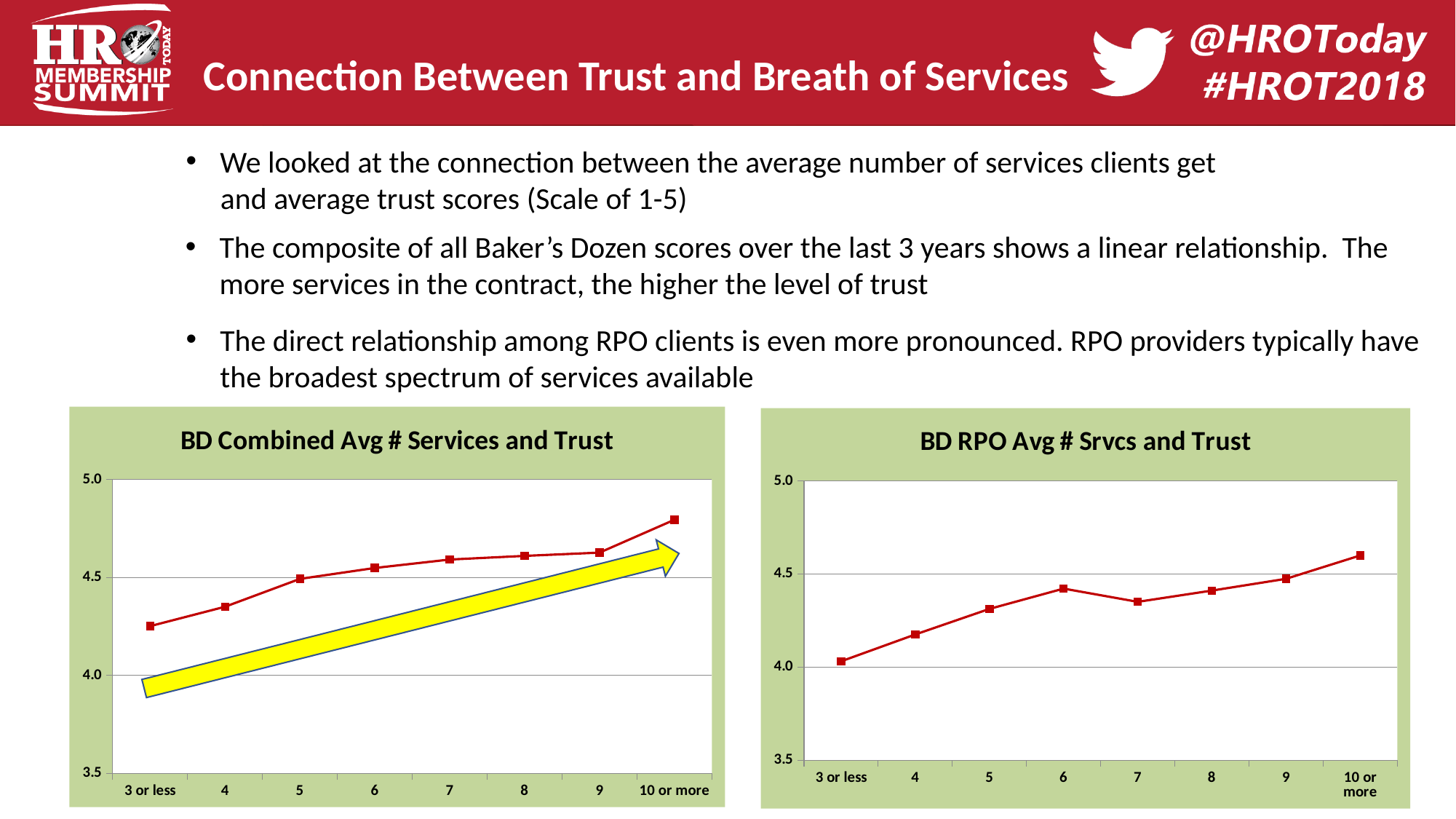
Do the values in the 'BD Combined Avg # Services and Trust' chart generally rise or fall from '3 or less' to '10 or more'? rise What kind of chart is the 'BD Combined Avg # Services and Trust' chart? line chart In the 'BD RPO Avg # Srvcs and Trust' chart, which category has the highest trust score? 10 or more In the 'BD RPO Avg # Srvcs and Trust' chart, is the value for '10 or more' greater or less than 4.5? greater In the 'BD RPO Avg # Srvcs and Trust' chart, is the value for '6' greater or less than 4.5? less In the 'BD Combined Avg # Services and Trust' chart, which category has the lowest trust score? 3 or less In the 'BD Combined Avg # Services and Trust' chart, which category has the highest trust score? 10 or more In the 'BD Combined Avg # Services and Trust' chart, is the value for '3 or less' greater or less than 4.5? less How many categories are shown on the x axis of the 'BD RPO Avg # Srvcs and Trust' chart? 8 In the 'BD RPO Avg # Srvcs and Trust' chart, which is larger, the value for '6' or the value for '7'? 6 In the 'BD RPO Avg # Srvcs and Trust' chart, which category has the lowest trust score? 3 or less